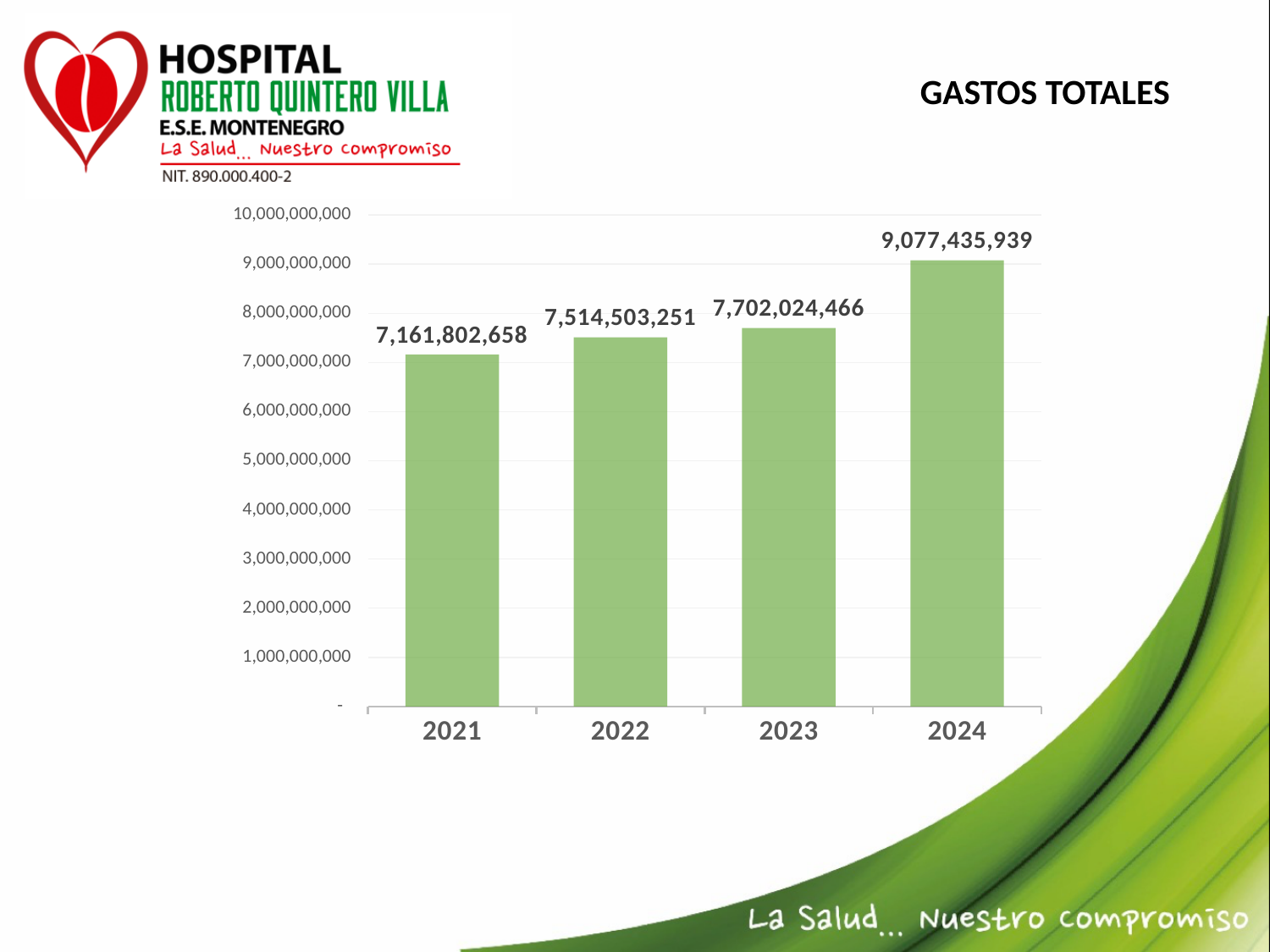
Which year has the highest value in the GASTOS TOTALES chart? 2024 What is the difference between the 2022 and 2021 values in the GASTOS TOTALES chart? 352,700,593 What is the value for 2024 in the GASTOS TOTALES chart? 9,077,435,939 Which year has the lowest value in the GASTOS TOTALES chart? 2021 What is the value for 2022 in the GASTOS TOTALES chart? 7,514,503,251 What kind of chart is the GASTOS TOTALES chart? Bar chart What is the difference between the 2024 and 2023 values in the GASTOS TOTALES chart? 1,375,411,473 How many years are shown in the GASTOS TOTALES chart? 4 What is the value for 2023 in the GASTOS TOTALES chart? 7,702,024,466 Which is larger in the GASTOS TOTALES chart, the value for 2022 or the value for 2023? 2023 Do the values in the GASTOS TOTALES chart rise or fall from 2021 to 2024? Rise What is the value for 2021 in the GASTOS TOTALES chart? 7,161,802,658